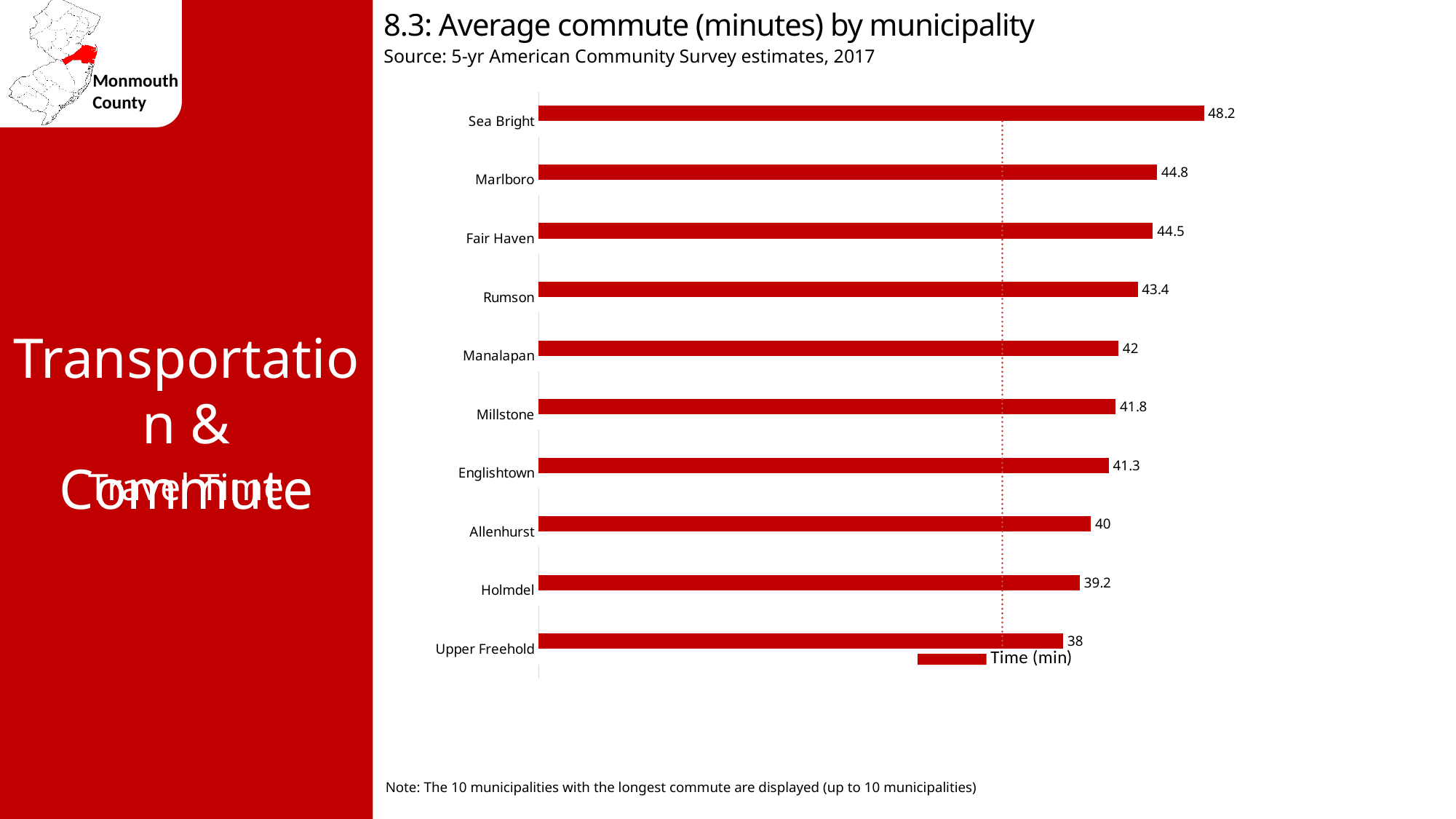
What is the average commute time for Rumson? 43.4 What kind of chart is used to show average commute by municipality? Bar chart Which has a longer average commute, Manalapan or Allenhurst? Manalapan What is the difference in average commute time between Marlboro and Fair Haven? 0.3 Which municipality has the longest average commute? Sea Bright What is the difference in average commute time between Sea Bright and Upper Freehold? 10.2 What is the title of the chart? 8.3: Average commute (minutes) by municipality How many series does the legend list? 1 Which municipality shown has the shortest average commute? Upper Freehold What is the average commute time for Holmdel? 39.2 How many municipalities are shown in the chart? 10 What is the average commute time for Sea Bright? 48.2